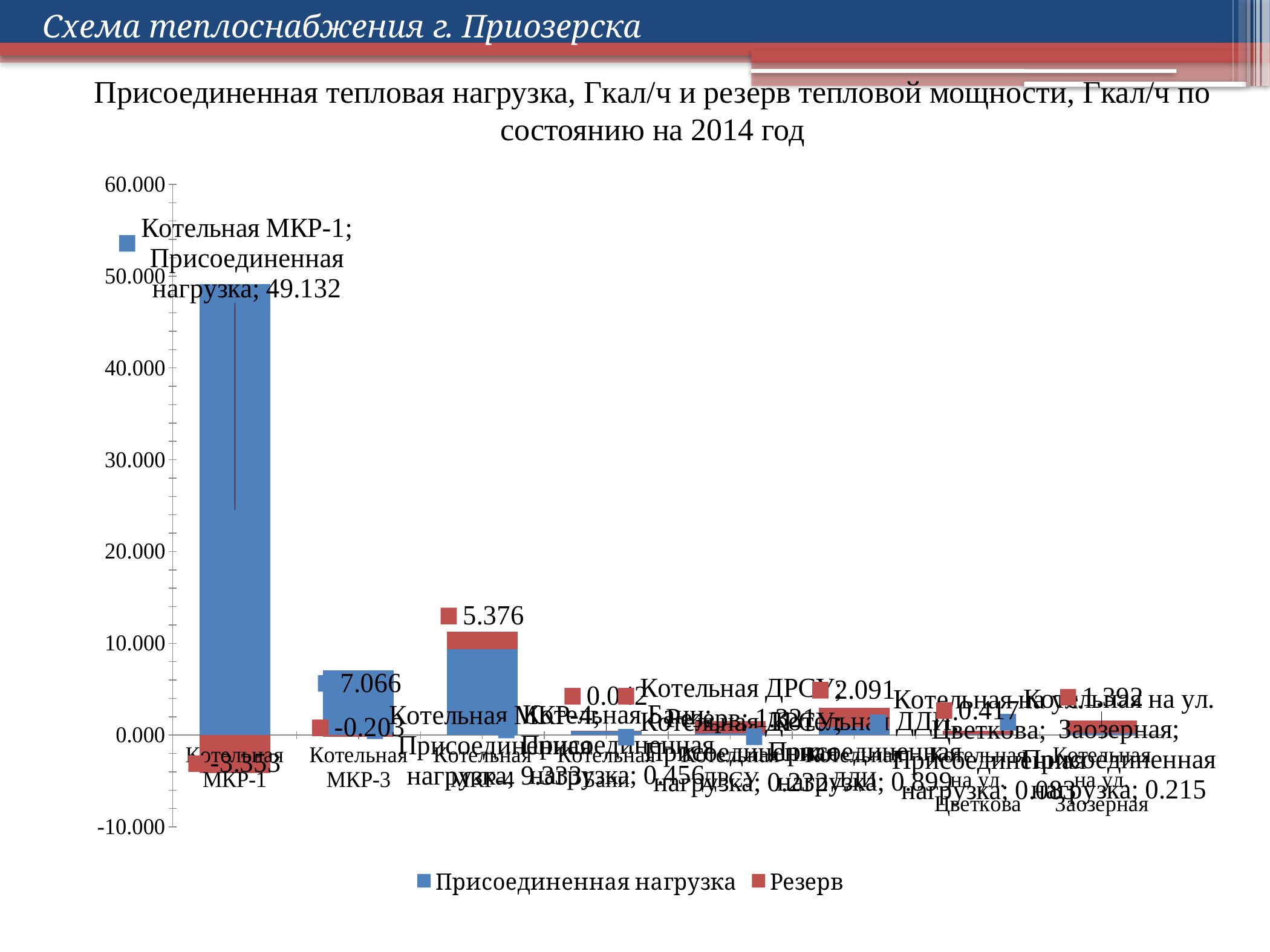
What is the Присоединенная нагрузка value for Котельная МКР-1? 49.132 What is the difference between the Присоединенная нагрузка of Котельная МКР-1 and Котельная МКР-4? 39.799 What is the Резерв value for Котельная МКР-1? -3.353 How many boiler houses (categories) are shown on the x axis? 8 What is the Присоединенная нагрузка value for Котельная МКР-4? 9.333 Is the Присоединенная нагрузка for Котельная МКР-1 greater or less than 40.000? greater Which boiler house has the highest Присоединенная нагрузка? Котельная МКР-1 What kind of chart is shown on the slide? bar chart What is the Резерв value for Котельная МКР-4? 5.376 Which has the larger Присоединенная нагрузка, Котельная МКР-3 or Котельная МКР-4? Котельная МКР-4 How many series does the legend list? 2